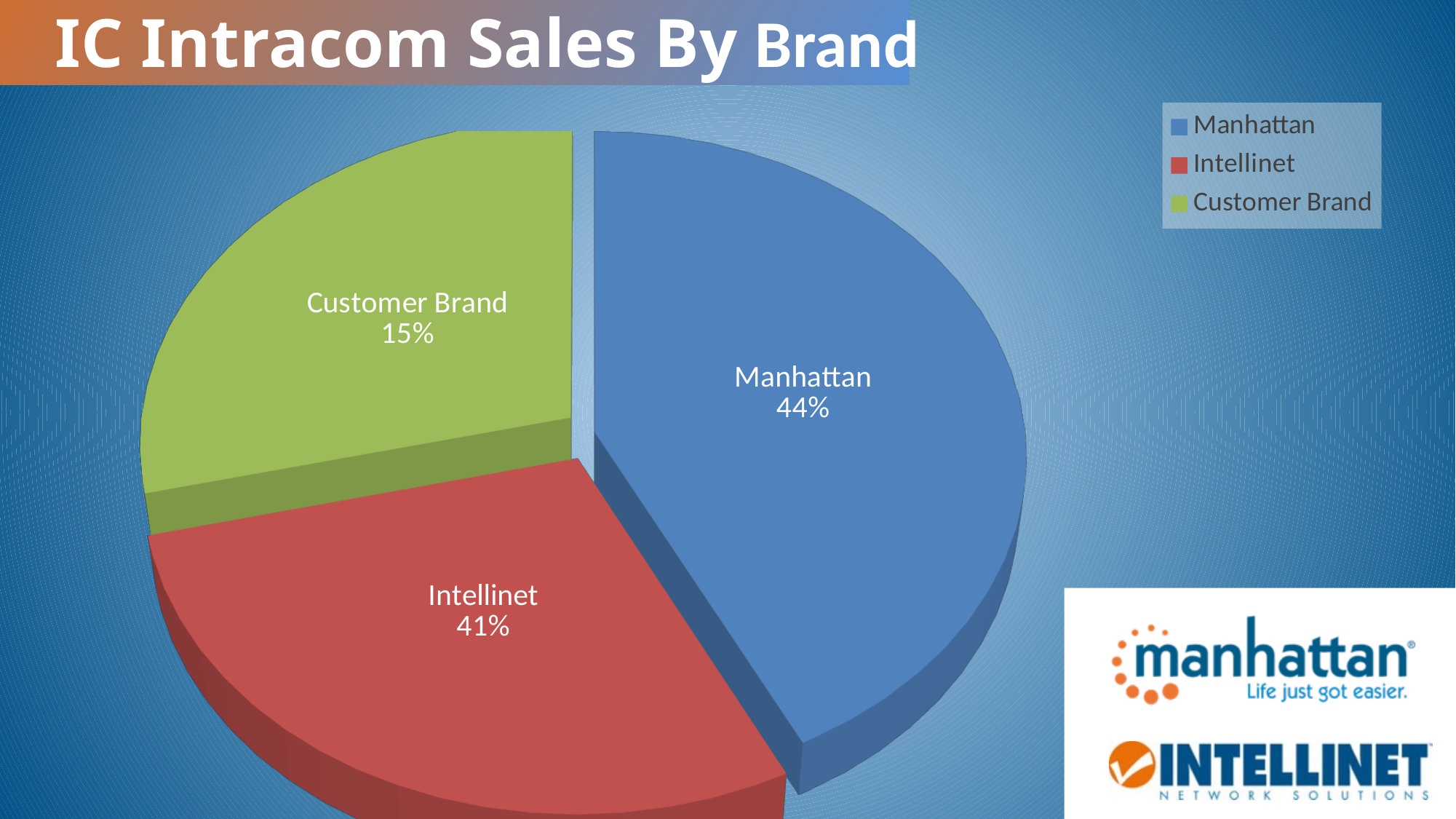
What is the title of the chart on the slide? IC Intracom Sales By Brand What is the difference in percentage points between the Intellinet and Customer Brand shares? 26 percentage points How many brands are shown in the pie chart? 3 What kind of chart is shown on the slide? Pie chart What share of IC Intracom sales does Customer Brand account for? 15% Which has a larger share of sales, Intellinet or Customer Brand? Intellinet What is the difference in percentage points between the Manhattan and Intellinet shares? 3 percentage points What share of IC Intracom sales does the Intellinet brand account for? 41% What colour represents Customer Brand in the pie chart? Green What share of IC Intracom sales does the Manhattan brand account for? 44% Which brand has the largest share of IC Intracom sales? Manhattan Which brand has the smallest share of IC Intracom sales? Customer Brand